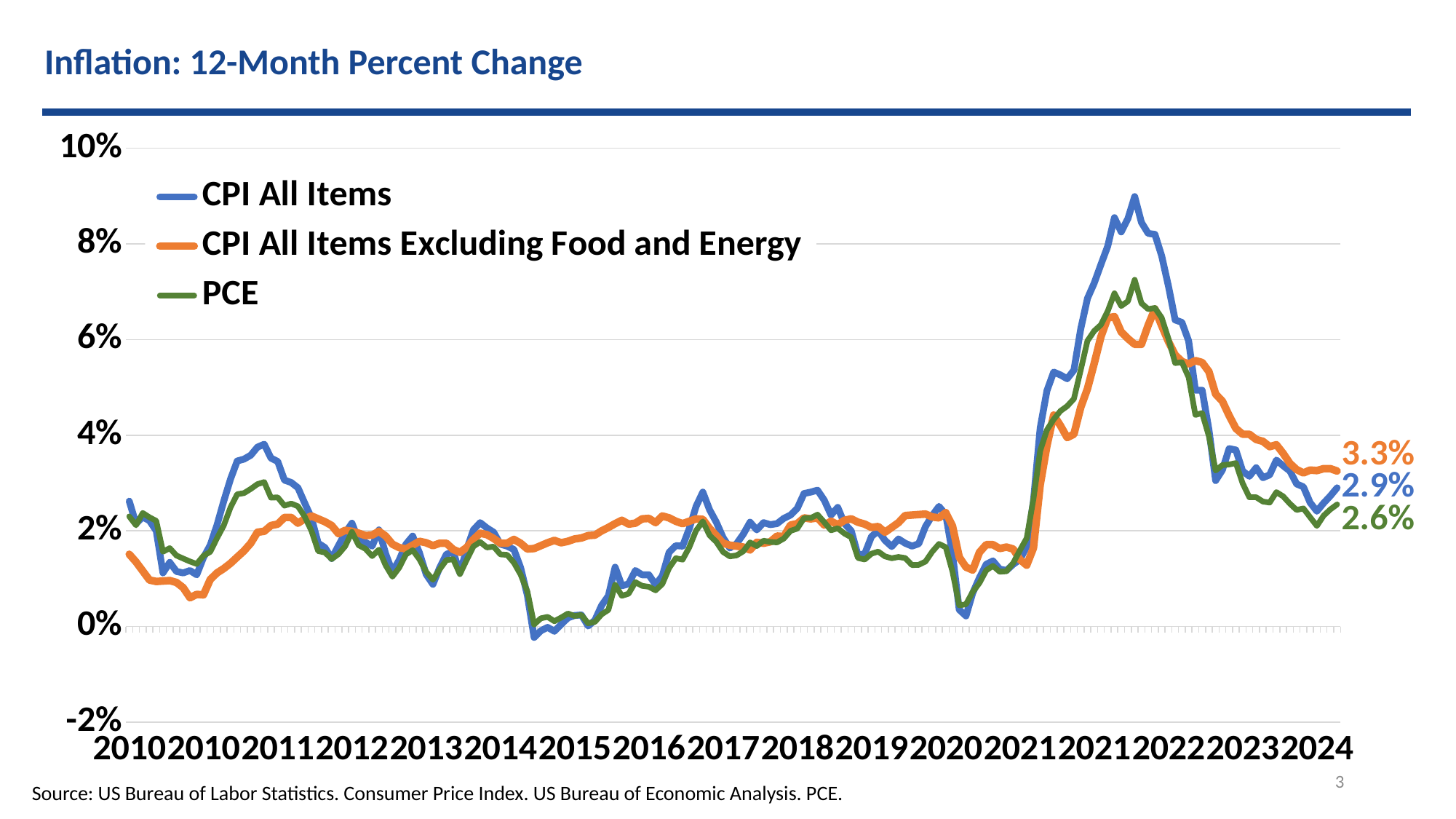
Which series has the lowest latest labeled value? PCE Is the latest labeled value for CPI All Items larger or smaller than the latest labeled value for PCE? larger Which series is drawn in green? PCE What is the latest labeled value for CPI All Items? 2.9% What is the latest labeled value for PCE? 2.6% What is the title of the chart? Inflation: 12-Month Percent Change What kind of chart is shown on the slide? line chart What is the difference between the latest labeled values for CPI All Items Excluding Food and Energy and PCE? 0.7% Which series has the highest latest labeled value? CPI All Items Excluding Food and Energy Is the peak value of the CPI All Items line greater or less than 8%? greater What is the latest labeled value for CPI All Items Excluding Food and Energy? 3.3% How many series does the legend list? 3